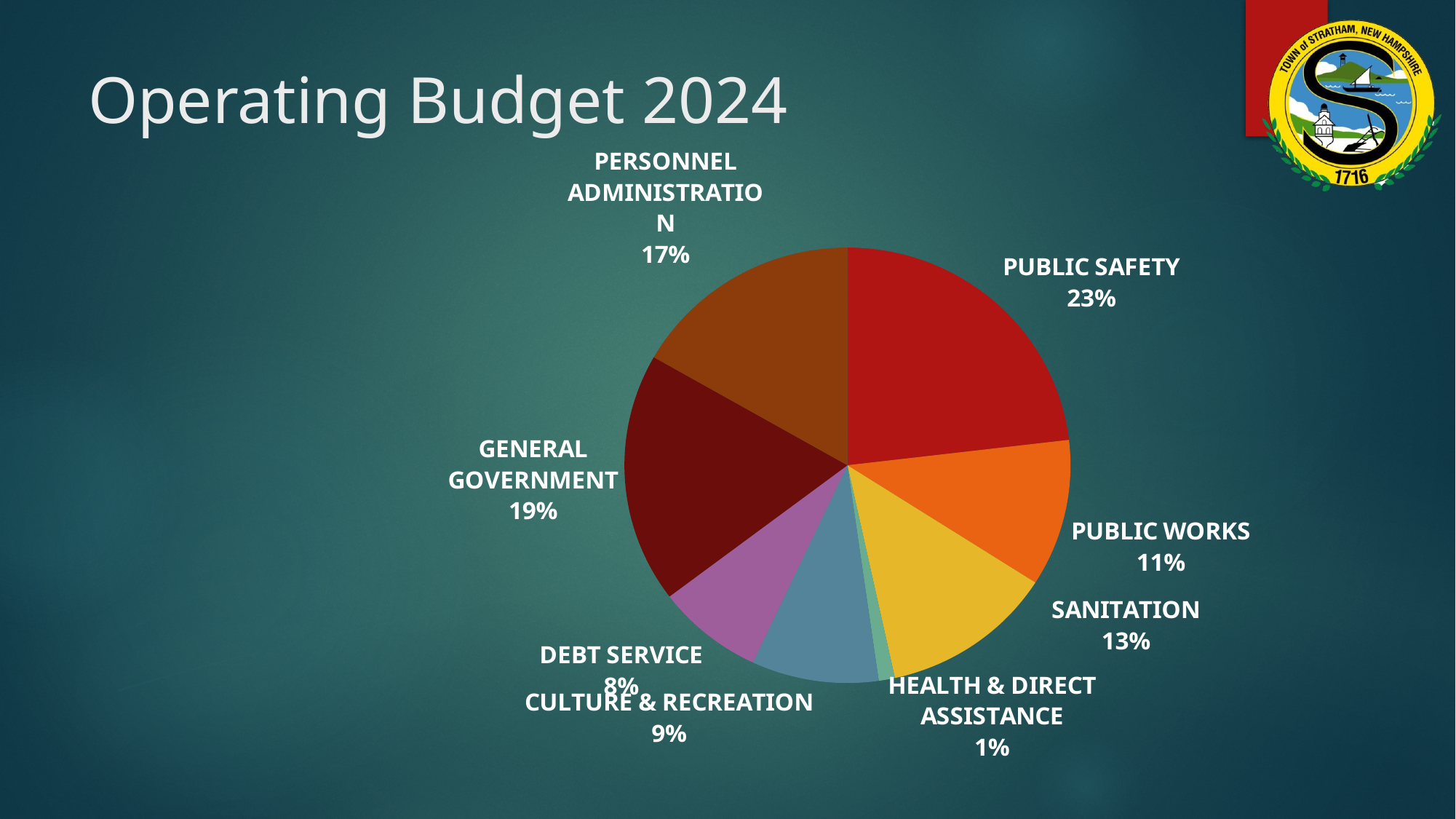
What is the difference in percentage points between Public Safety and Public Works? 12 Which category has the largest share of the pie? Public Safety What is the title of the slide's chart? Operating Budget 2024 What is the difference in percentage points between Culture & Recreation and Debt Service? 1 What percentage is shown for Health & Direct Assistance? 1% What kind of chart is shown on the slide? Pie chart Which category has the smallest share of the pie? Health & Direct Assistance What share of the operating budget goes to Public Safety? 23% How many categories are shown in the pie chart? 8 What percentage is shown for General Government? 19% Which is larger, Personnel Administration or Debt Service? Personnel Administration What percentage is shown for Sanitation? 13%